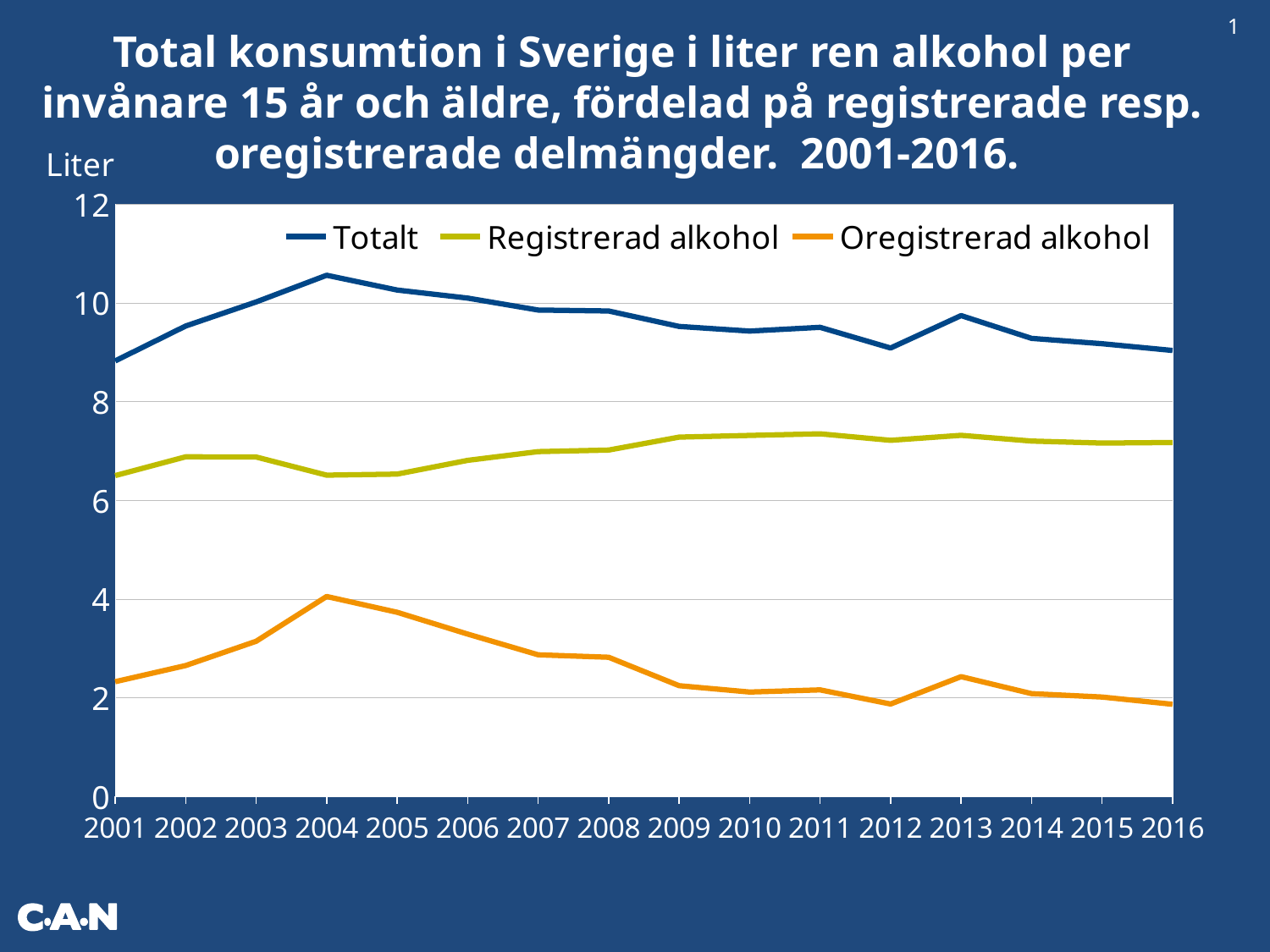
Does the Oregistrerad alkohol series rise or fall between 2004 and 2012? fall Is the value for Totalt in 2001 greater or less than 10? less How many series does the legend list? 3 Is the value for Registrerad alkohol in 2011 greater or less than 6? greater What unit label is shown above the y axis? Liter What kind of chart is shown on the slide? line chart How many years are plotted along the x axis? 16 In which year does the Totalt series reach its highest value? 2004 Is the value for Totalt in 2004 greater or less than 10? greater Which is larger in 2010, Registrerad alkohol or Oregistrerad alkohol? Registrerad alkohol In which year does the Oregistrerad alkohol series reach its highest value? 2004 In which year is the Totalt series at its lowest value? 2001